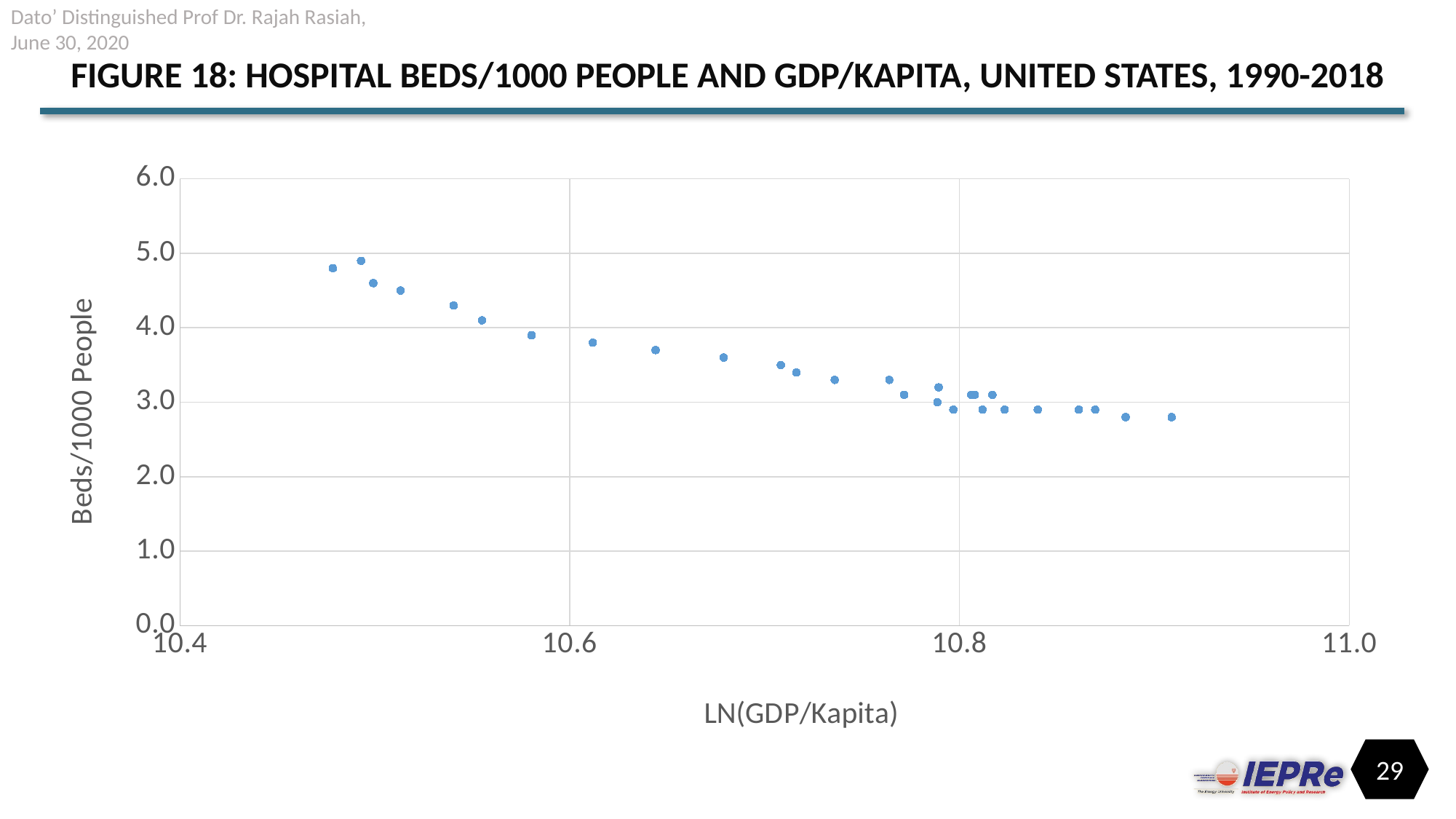
What kind of chart is shown on the slide? Scatter chart Which has the higher Beds/1000 People value: the leftmost point or the rightmost point? The leftmost point What is the label of the x axis? LN(GDP/Kapita) Is the highest plotted value for Beds/1000 People greater or less than 4.0? greater What is the label of the y axis? Beds/1000 People Is the lowest plotted value for Beds/1000 People greater or less than 3.0? less Is the value for Beds/1000 People at the leftmost point (around LN(GDP/Kapita) 10.48) greater or less than 4.0? greater As LN(GDP/Kapita) increases along the x axis, do the values for Beds/1000 People rise or fall? Fall